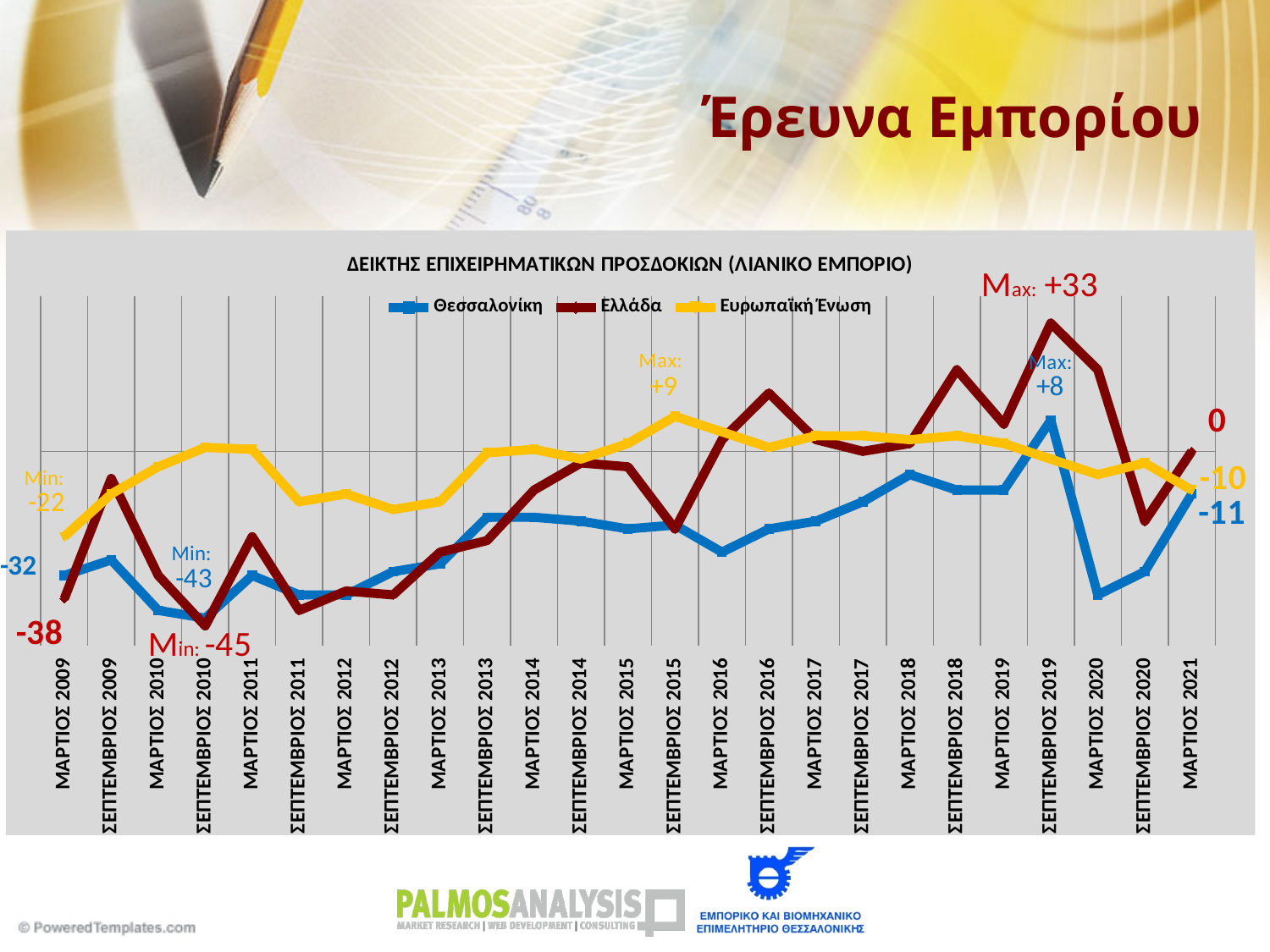
What is the difference between the maximum of Ελλάδα (+33) and the maximum of Θεσσαλονίκη (+8)? 25 What is the maximum value reached by the Ελλάδα series? +33 What is the value for Ευρωπαϊκή Ένωση in ΜΑΡΤΙΟΣ 2021? -10 What is the value for Θεσσαλονίκη in ΜΑΡΤΙΟΣ 2009? -32 What kind of chart is shown on the slide? line chart What is the minimum value reached by the Θεσσαλονίκη series? -43 What is the value for Θεσσαλονίκη in ΜΑΡΤΙΟΣ 2021? -11 How many series does the chart legend list? 3 Which series has the higher value in ΜΑΡΤΙΟΣ 2021, Ελλάδα or Θεσσαλονίκη? Ελλάδα What is the title of the chart? ΔΕΙΚΤΗΣ ΕΠΙΧΕΙΡΗΜΑΤΙΚΩΝ ΠΡΟΣΔΟΚΙΩΝ (ΛΙΑΝΙΚΟ ΕΜΠΟΡΙΟ) What is the value for Ελλάδα in ΜΑΡΤΙΟΣ 2021? 0 What is the value for Ελλάδα in ΜΑΡΤΙΟΣ 2009? -38